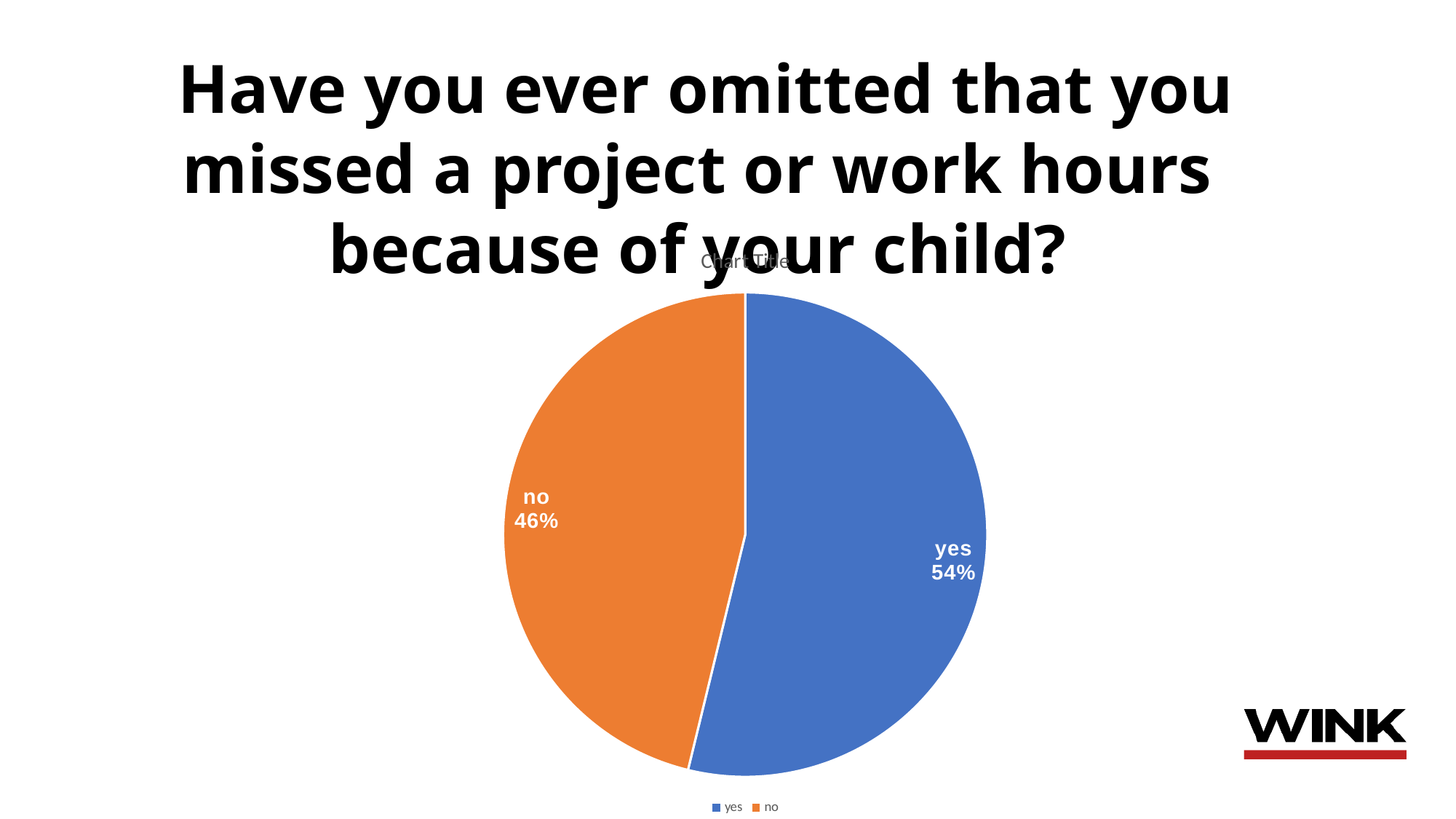
Which response has the larger share of the pie? yes What percentage of respondents answered "no"? 46% How many entries does the legend list? 2 Is the share for "yes" larger or smaller than the share for "no"? larger How many slices does the pie chart have? 2 By how many percentage points does "yes" exceed "no"? 8 What type of chart is shown on the slide? pie chart What percentage of respondents answered "yes"? 54% What colour is the "yes" slice? blue Which response has the smaller share of the pie? no What colour is the "no" slice? orange